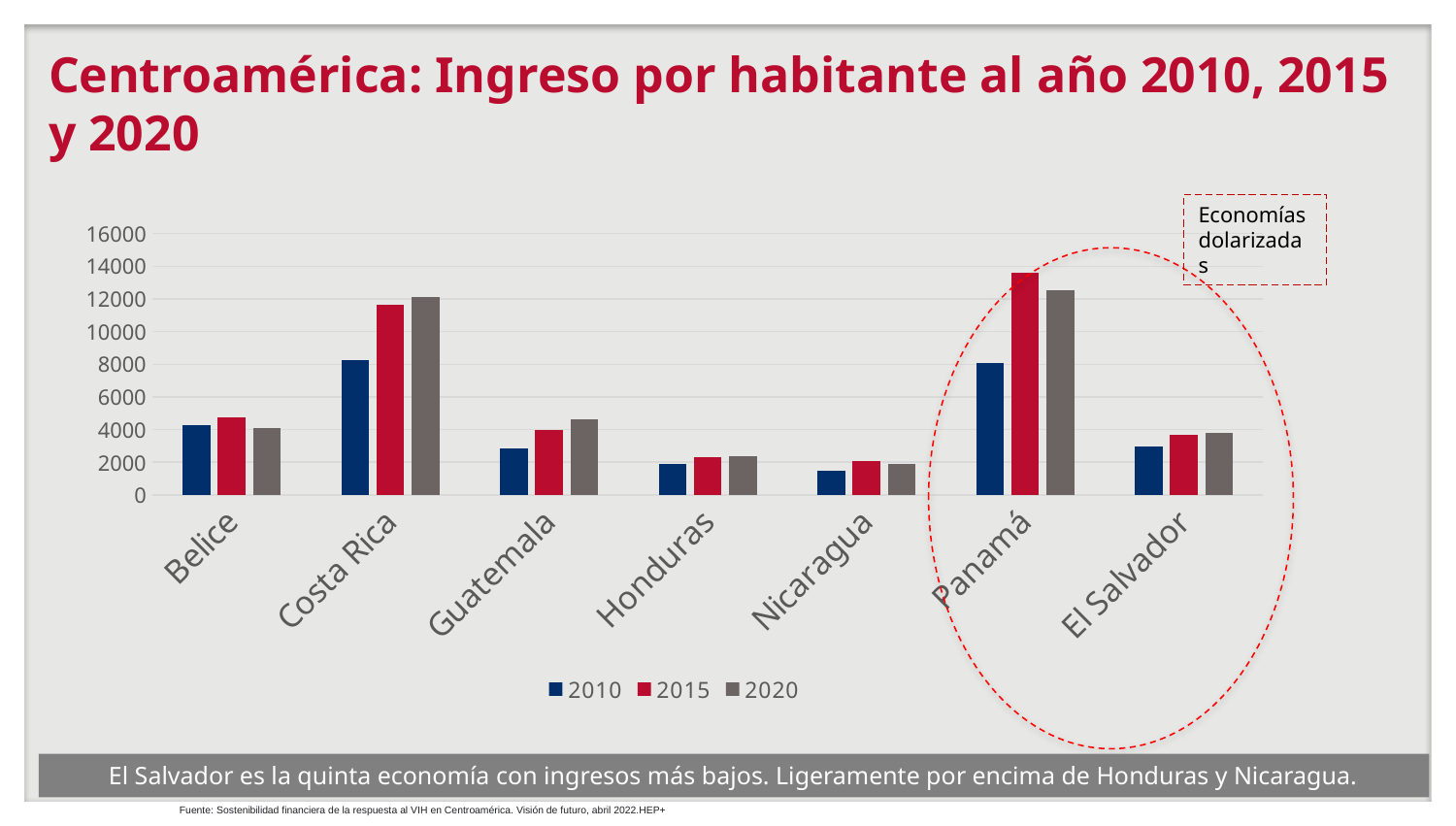
What are the entries listed in the chart legend? 2010, 2015, 2020 Is the 2020 value for Costa Rica greater or less than 10000? greater Is the 2015 value for Honduras greater or less than 4000? less How many countries are shown on the x axis of the chart? 7 Which country has the lowest value for 2010? Nicaragua Which country has the highest value for 2015? Panamá Do the values for Costa Rica rise or fall from 2010 to 2020? rise Is the 2015 value for Panamá greater or less than 12000? greater Which is larger, the 2020 value for Guatemala or the 2020 value for Nicaragua? Guatemala Which is larger, the 2015 value for Costa Rica or the 2015 value for Belice? Costa Rica What kind of chart is shown on the slide? bar chart How many series does the legend list? 3